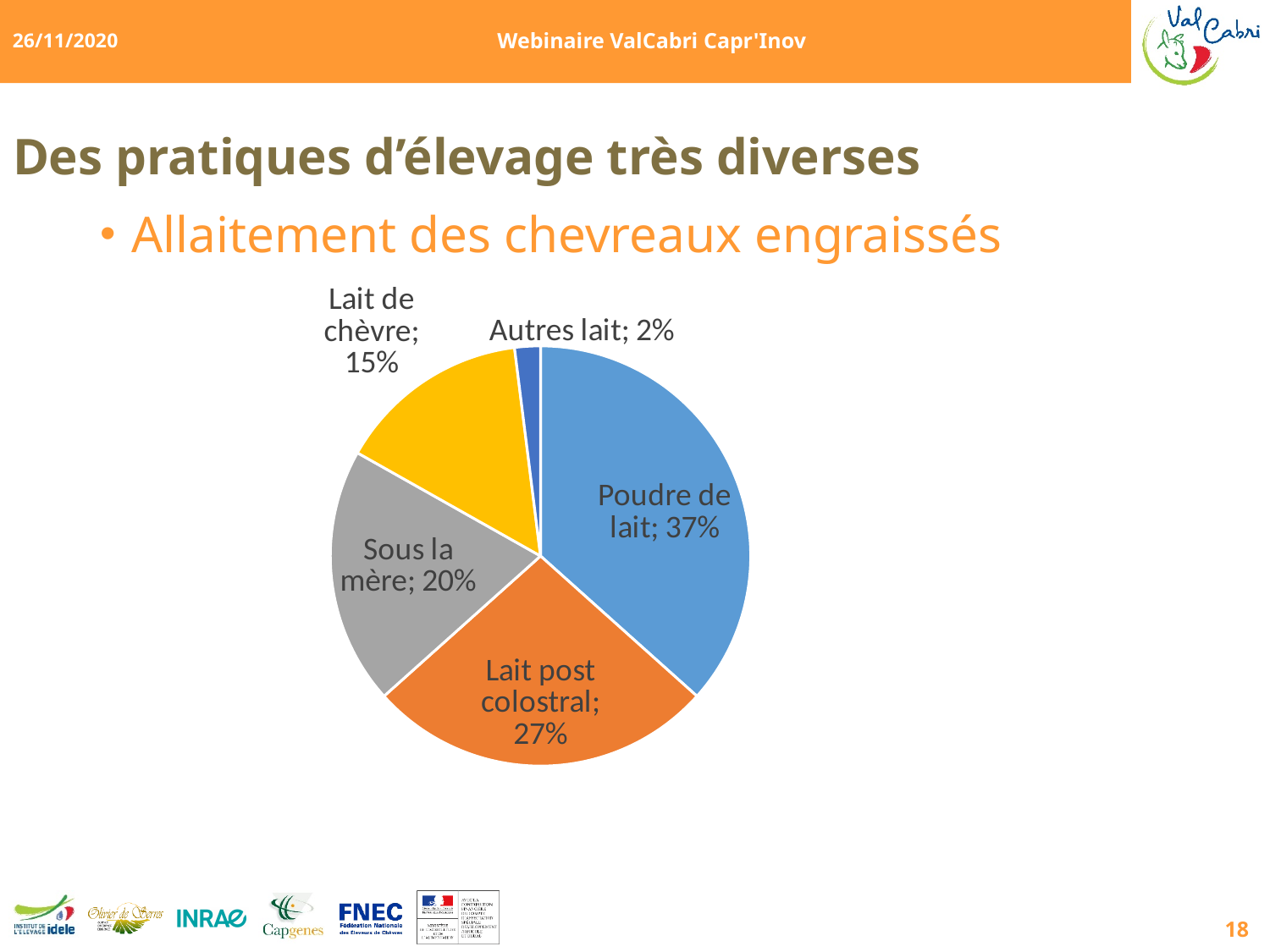
What is the value for "Lait post colostral"? 27% What is the value for "Autres lait"? 2% What type of chart is shown on the slide? pie chart Which is larger, the share for "Sous la mère" or the share for "Lait de chèvre"? Sous la mère What colour is the "Lait de chèvre" slice? yellow Which category has the largest share of the pie? Poudre de lait What is the value for "Sous la mère"? 20% How many slices does the pie chart have? 5 What is the difference between the shares of "Poudre de lait" and "Lait post colostral"? 10% What share of the pie does "Poudre de lait" represent? 37% What is the value for "Lait de chèvre"? 15% Which category has the smallest share of the pie? Autres lait